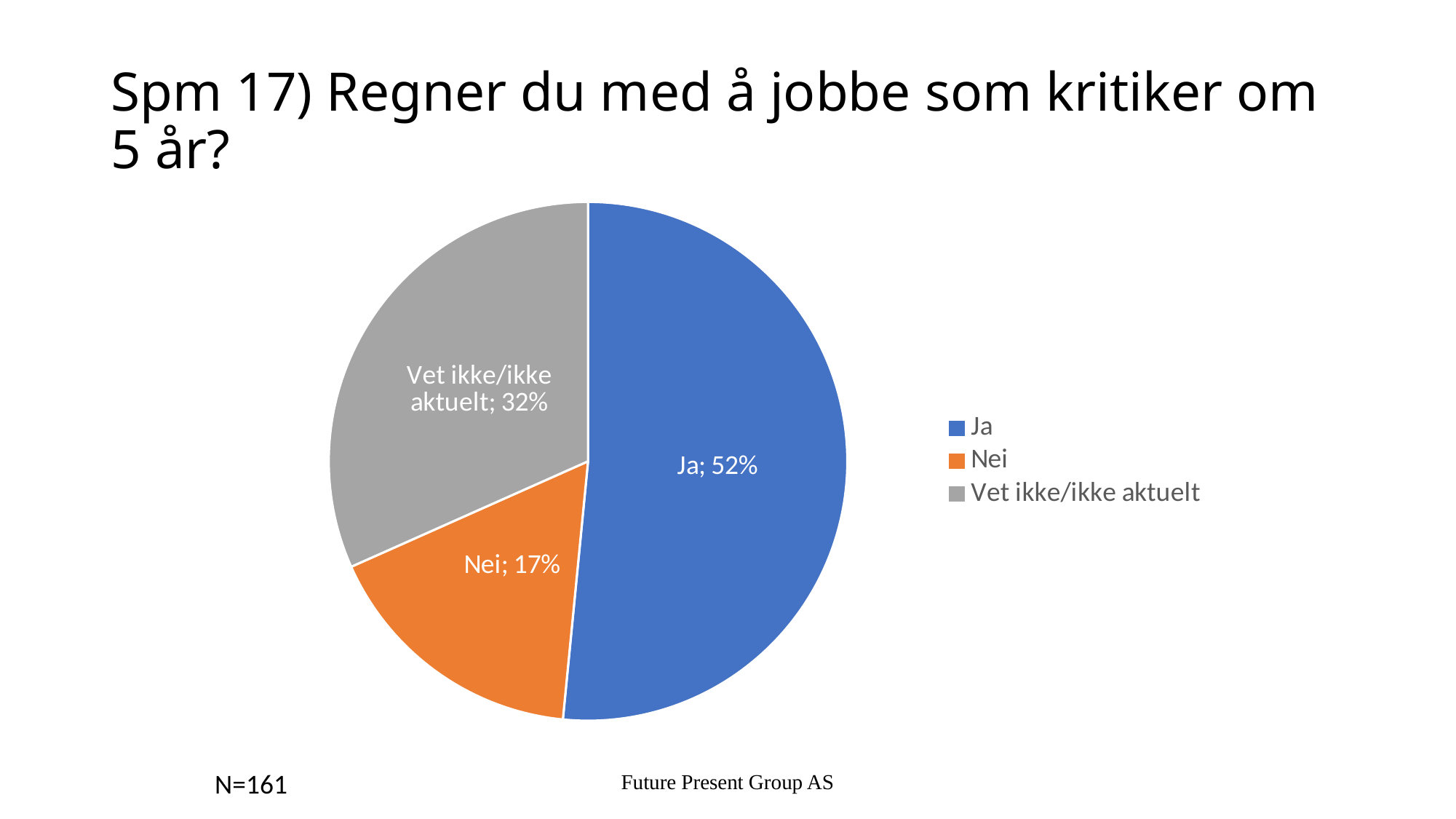
What kind of chart is shown on the slide? pie chart Which is larger, the "Vet ikke/ikke aktuelt" slice or the "Nei" slice? Vet ikke/ikke aktuelt Which slice of the pie is the smallest? Nei What share of the pie is labelled "Nei"? 17% How many entries does the legend list? 3 What share of the pie is labelled "Ja"? 52% Which slice of the pie is the largest? Ja What share of the pie is labelled "Vet ikke/ikke aktuelt"? 32% How many slices does the pie chart have? 3 What is the sample size (N) stated on the slide? N=161 What colour is the "Nei" slice in the pie chart? orange What is the difference in percentage points between the "Ja" slice and the "Nei" slice? 35